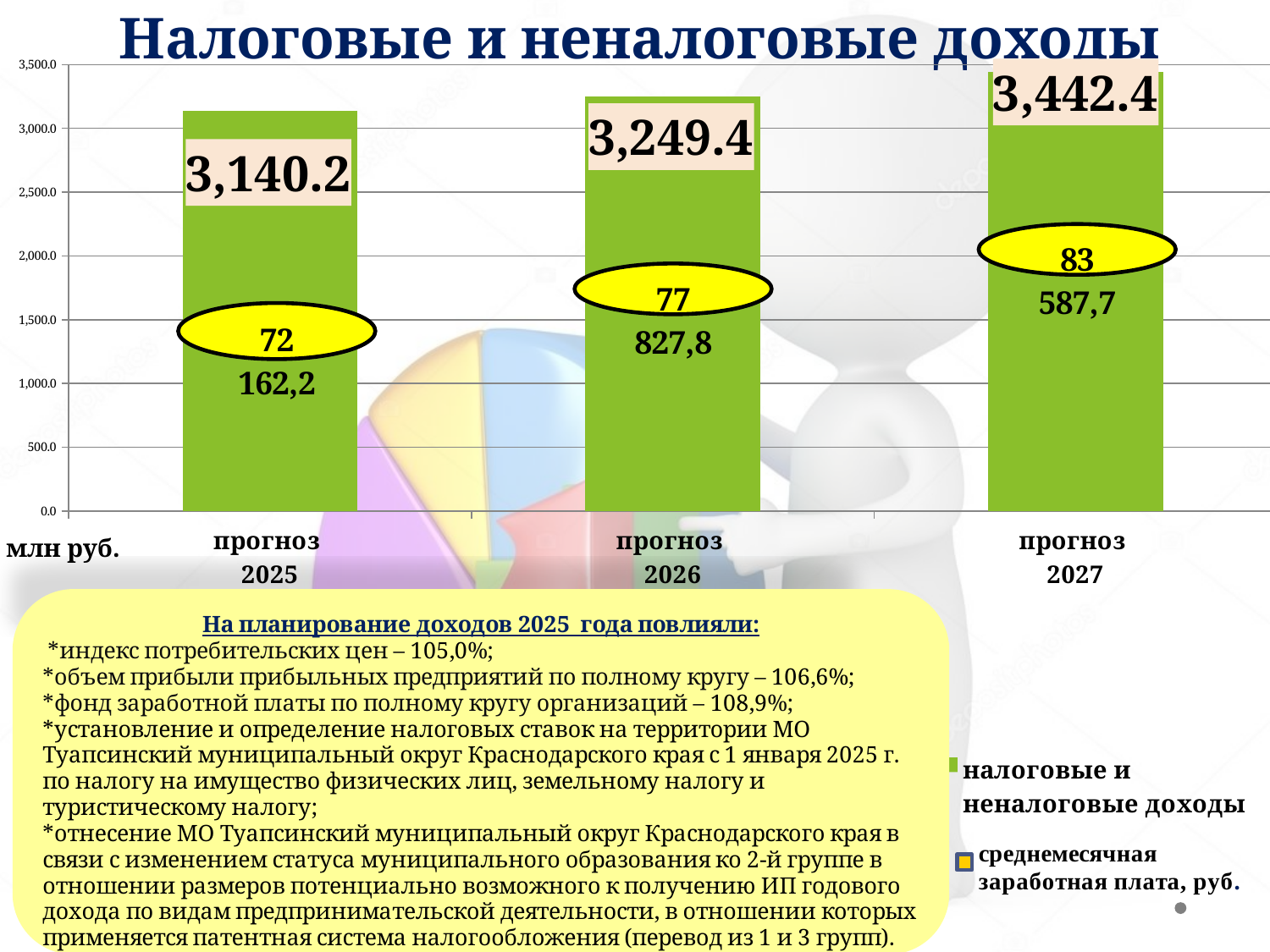
How many forecast years (categories) are shown on the chart? 3 What is the difference between the налоговые и неналоговые доходы values for прогноз 2027 and прогноз 2025? 302.2 Which forecast year has the highest value of налоговые и неналоговые доходы? прогноз 2027 What is the value of налоговые и неналоговые доходы for прогноз 2027? 3,442.4 Is the value for прогноз 2025 greater or less than 3,000.0? greater How many series does the legend list? 2 What is the value of налоговые и неналоговые доходы for прогноз 2025? 3,140.2 What kind of chart is shown on the slide? bar chart What is the value of налоговые и неналоговые доходы for прогноз 2026? 3,249.4 Which forecast year has the lowest value of налоговые и неналоговые доходы? прогноз 2025 Do the налоговые и неналоговые доходы values rise or fall from прогноз 2025 to прогноз 2027? rise Which is larger: the налоговые и неналоговые доходы value for прогноз 2026 or for прогноз 2025? прогноз 2026